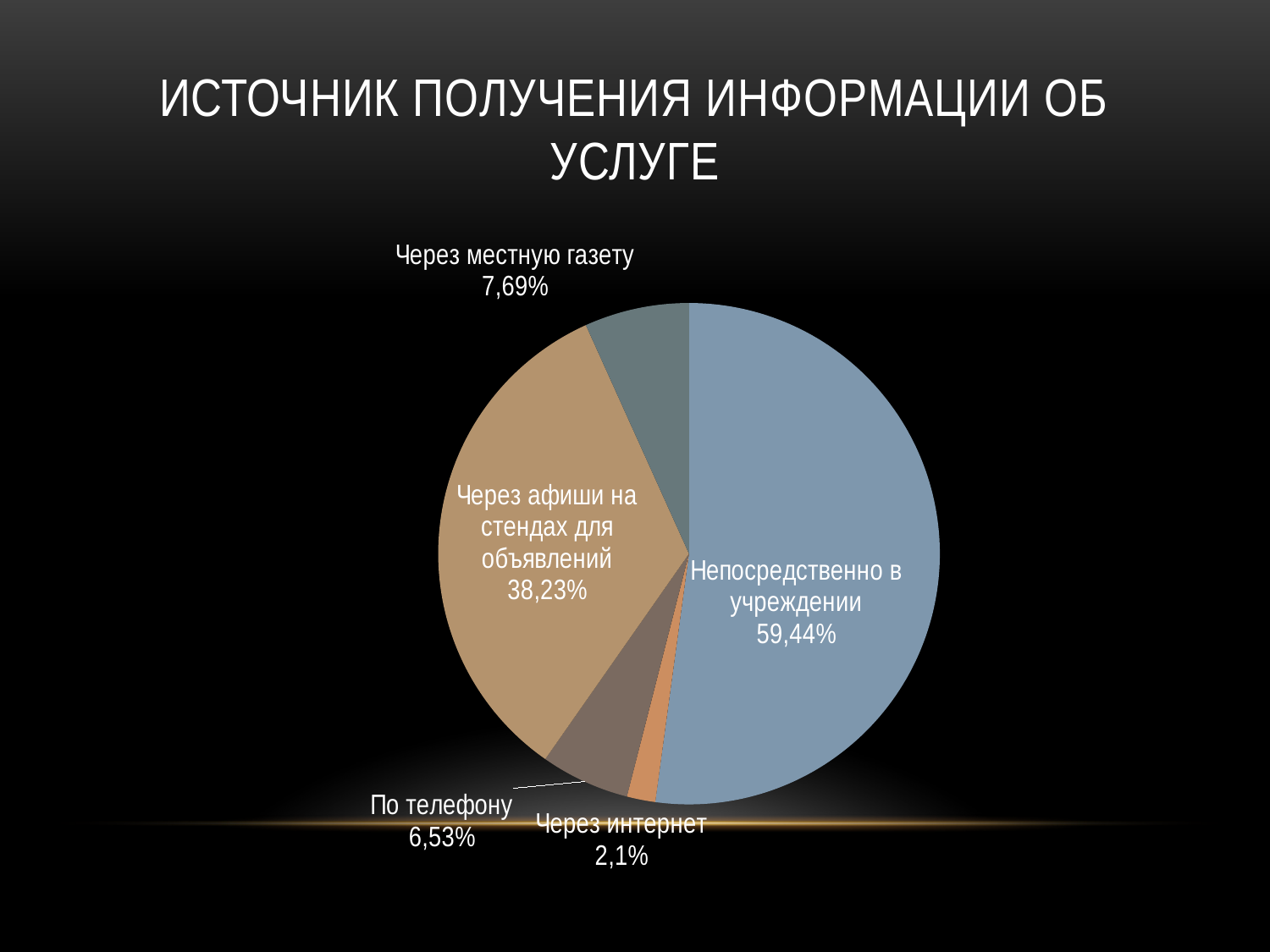
What is the value for "Через местную газету"? 7,69% Which is larger, "Через местную газету" or "По телефону"? Через местную газету What is the title of the chart? ИСТОЧНИК ПОЛУЧЕНИЯ ИНФОРМАЦИИ ОБ УСЛУГЕ Which source has the smallest share? Через интернет What is the value for "Через афиши на стендах для объявлений"? 38,23% How many slices does the pie chart have? 5 What is the value for "Через интернет"? 2,1% What is the difference between "Непосредственно в учреждении" and "Через афиши на стендах для объявлений"? 21,21% What is the value for "Непосредственно в учреждении"? 59,44% What is the value for "По телефону"? 6,53% What kind of chart is shown on the slide? pie chart Which source has the largest share? Непосредственно в учреждении